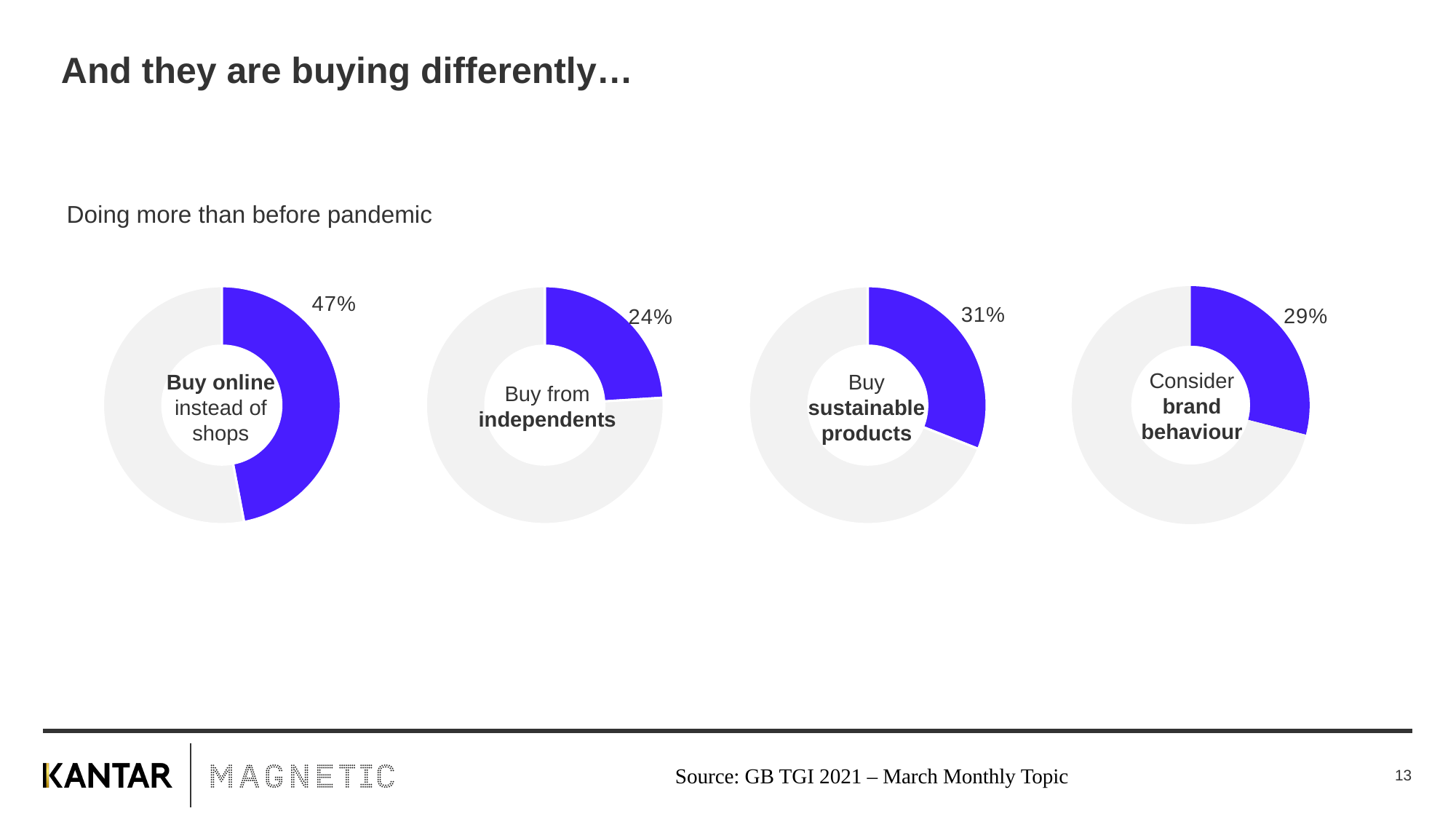
What percentage is shown on the 'Buy online instead of shops' donut chart? 47% What colour is used for the highlighted segment in each donut chart? Purple What percentage is shown on the 'Consider brand behaviour' donut chart? 29% Which of the four donut charts shows the lowest percentage? Buy from independents What kind of chart is used to show each percentage on the slide? Donut (pie) chart Which of the four donut charts shows the highest percentage? Buy online instead of shops How many donut charts are shown on the slide? 4 What is the difference in percentage points between the 'Buy sustainable products' chart and the 'Consider brand behaviour' chart? 2 Which is larger: the percentage on the 'Buy sustainable products' chart or the percentage on the 'Consider brand behaviour' chart? Buy sustainable products What percentage is shown on the 'Buy from independents' donut chart? 24% What is the difference in percentage points between the 'Buy online instead of shops' chart and the 'Buy from independents' chart? 23 What percentage is shown on the 'Buy sustainable products' donut chart? 31%